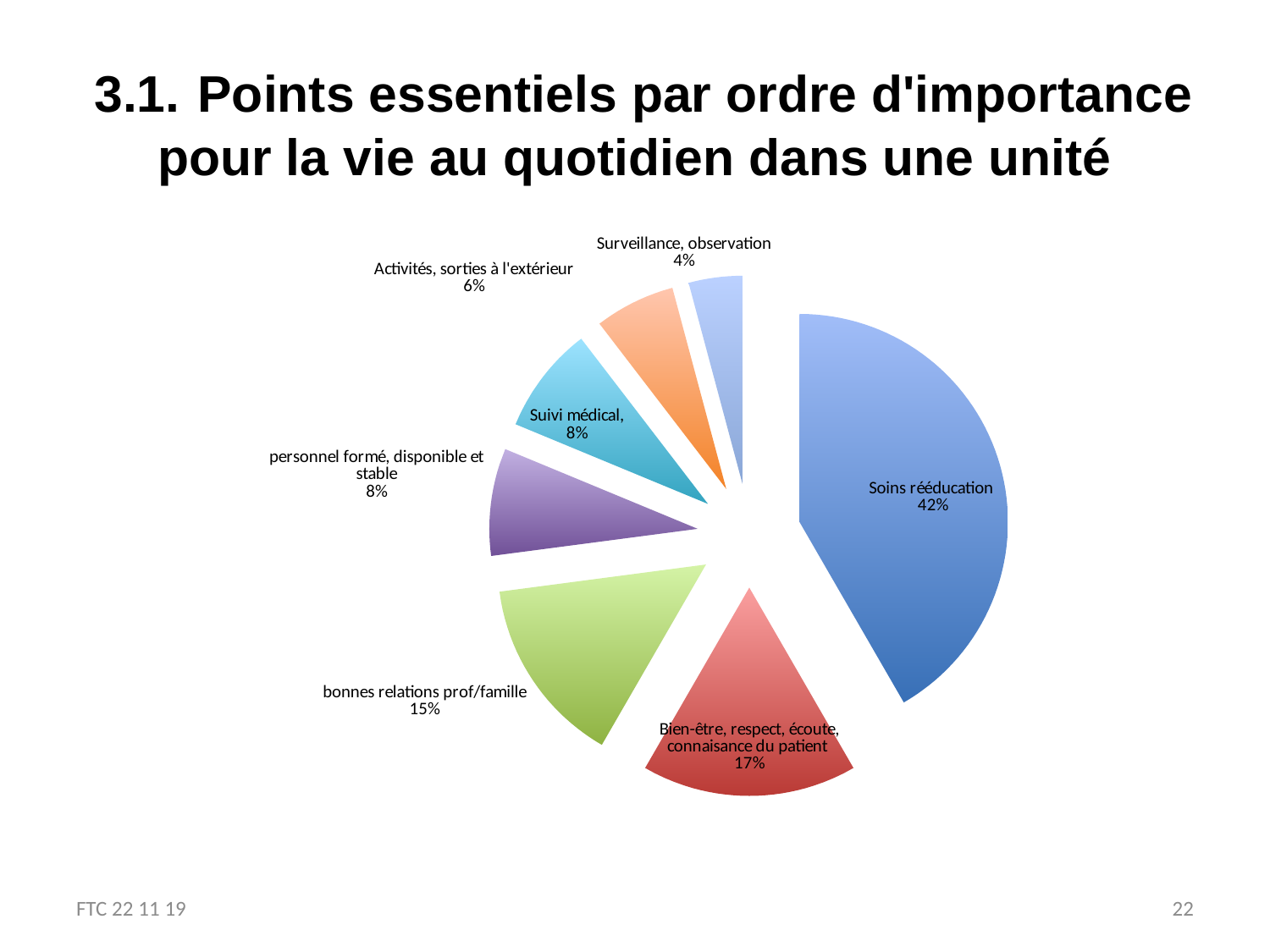
What share of the pie does "Soins rééducation" represent? 42% What is the value for "bonnes relations prof/famille"? 15% What is the value for "Activités, sorties à l'extérieur"? 6% What is the value for "Bien-être, respect, écoute, connaisance du patient"? 17% Which is larger: "bonnes relations prof/famille" or "Suivi médical"? bonnes relations prof/famille What kind of chart is shown on the slide? pie chart How many slices does the pie chart have? 7 Which category has the smallest slice of the pie? Surveillance, observation Which category has the largest slice of the pie? Soins rééducation What is the difference between the shares of "Soins rééducation" and "Bien-être, respect, écoute, connaisance du patient"? 25% What is the value for "Surveillance, observation"? 4% What colour is the "Soins rééducation" slice? blue